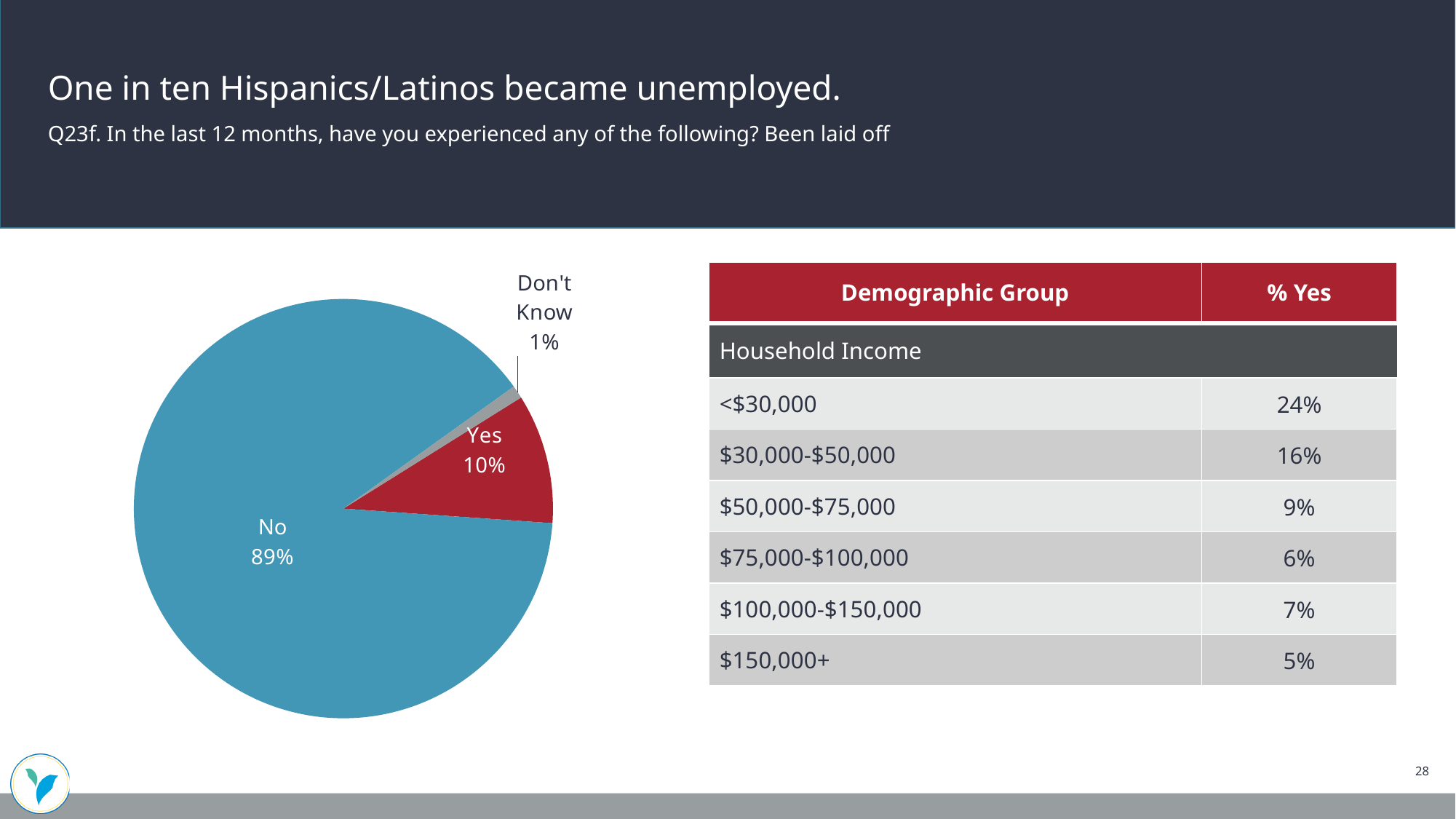
What kind of chart is shown on the slide? pie chart How many slices does the pie chart have? 3 What colour is the "No" slice of the pie chart? blue What is the difference in percentage points between the "No" slice and the "Yes" slice? 79 Which is larger in the pie chart, the "Yes" slice or the "Don't Know" slice? Yes What share of the pie chart is labelled "Don't Know"? 1% What colour is the "Yes" slice of the pie chart? red What share of the pie chart is labelled "No"? 89% Which slice of the pie chart is the smallest? Don't Know What share of the pie chart is labelled "Yes"? 10% Which slice of the pie chart is the largest? No